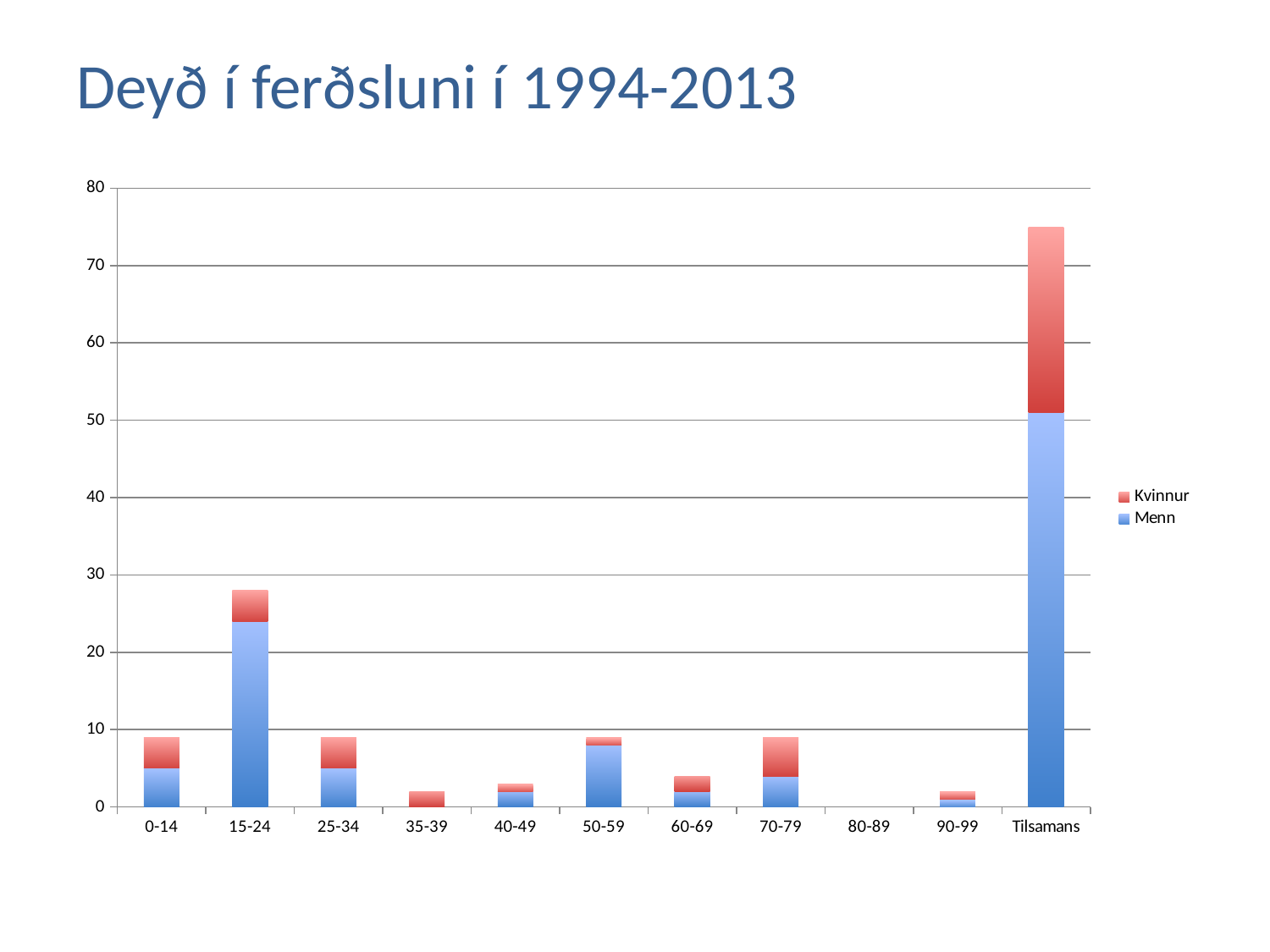
Is the Menn value for 15-24 greater or less than 20? greater What is the title of the chart? Deyð í ferðsluni í 1994-2013 Which age group has the taller stacked bar, 15-24 or 25-34? 15-24 What kind of chart is shown on the slide? bar chart How many series does the legend list? 2 Is the total value for 0-14 greater or less than 10? less How many categories are shown on the x axis? 11 Which age group has no bar at all (the lowest value)? 80-89 Is the total value for 15-24 greater or less than 30? less Which series is shown in red in the legend? Kvinnur Which category has the tallest stacked bar? Tilsamans